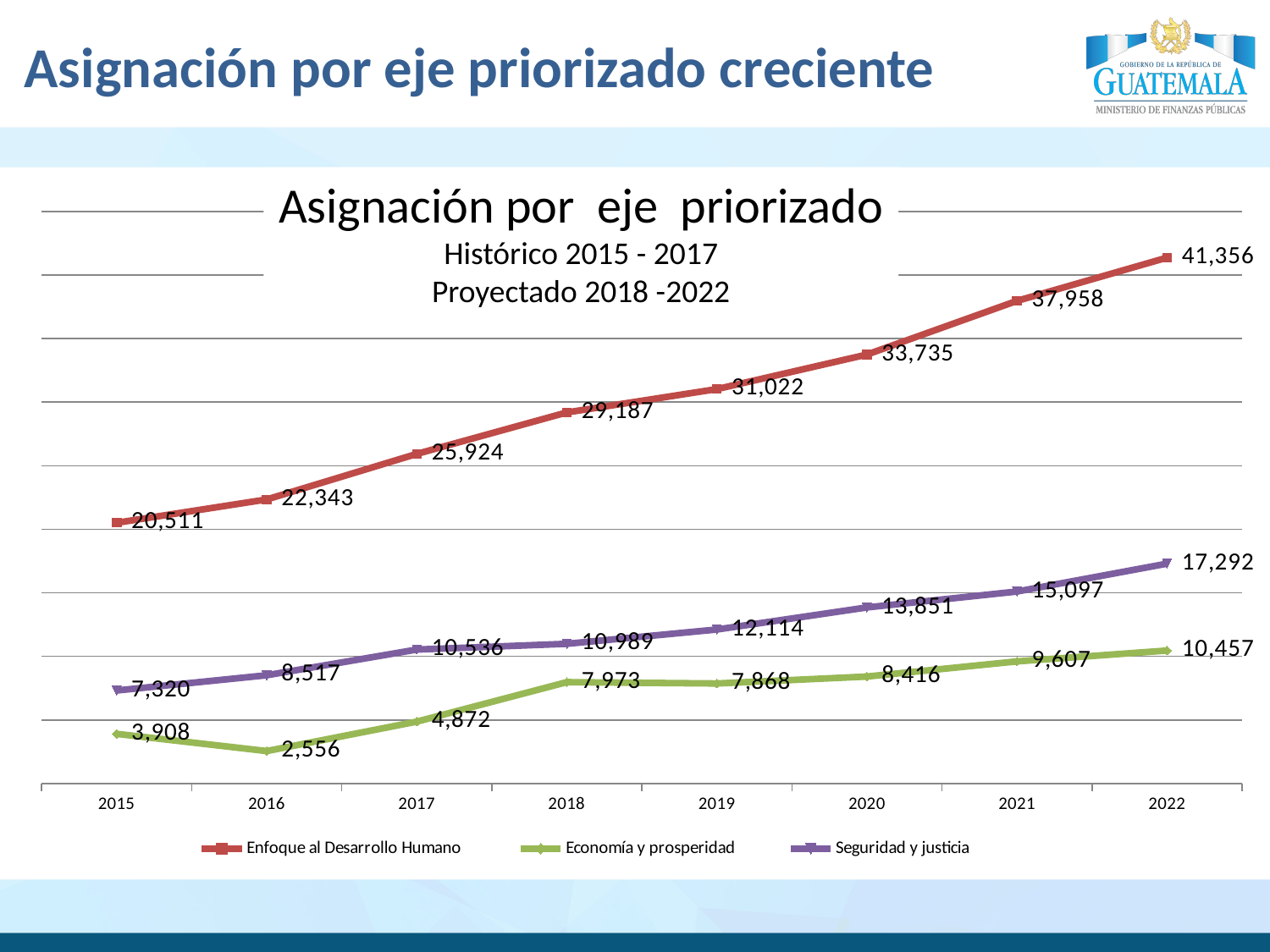
Which is larger in 2018: Economía y prosperidad or Seguridad y justicia? Seguridad y justicia Which series is drawn in green? Economía y prosperidad What is the value for Economía y prosperidad in 2016? 2,556 In which year is the value for Economía y prosperidad lowest? 2016 How many years are shown on the x axis? 8 How many series does the legend list? 3 What is the value for Enfoque al Desarrollo Humano in 2022? 41,356 What type of chart is shown on the slide? Line chart What is the value for Seguridad y justicia in 2019? 12,114 What is the difference between the Enfoque al Desarrollo Humano values in 2022 and 2015? 20,845 In which year is the value for Seguridad y justicia highest? 2022 Does the Enfoque al Desarrollo Humano series rise or fall from 2015 to 2022? Rise